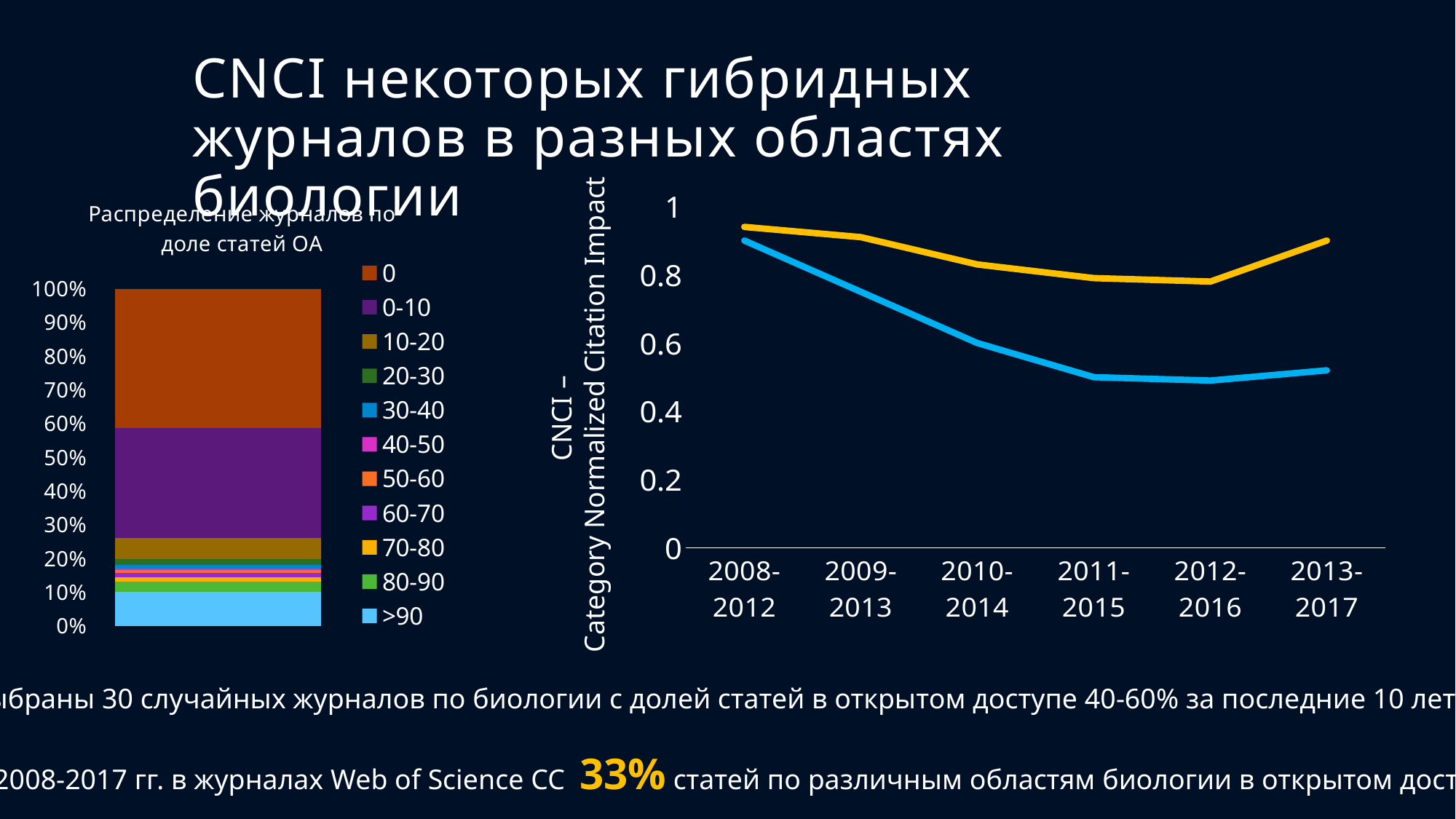
What kind of chart is the chart on the right of the slide (with the CNCI axis)? line chart In the chart on the right, how many time periods are shown on the x axis? 6 In the chart on the right, is the value of the blue line for 2008-2012 greater or less than 0.8? greater In the chart on the right, how many lines are plotted? 2 How many entries does the legend of the chart "Распределение журналов по доле статей OA" list? 11 What kind of chart is the chart titled "Распределение журналов по доле статей OA"? bar chart In the chart on the right, is the value of the yellow line for 2013-2017 greater or less than 0.8? greater In the chart on the right, is the value of the blue line for 2011-2015 greater or less than 0.6? less In the chart on the right, which line is higher in 2011-2015, the yellow line or the blue line? the yellow line In the chart "Распределение журналов по доле статей OA", which legend category occupies the largest share of the bar? 0 In the chart on the right, does the blue line rise or fall from 2008-2012 to 2013-2017? fall